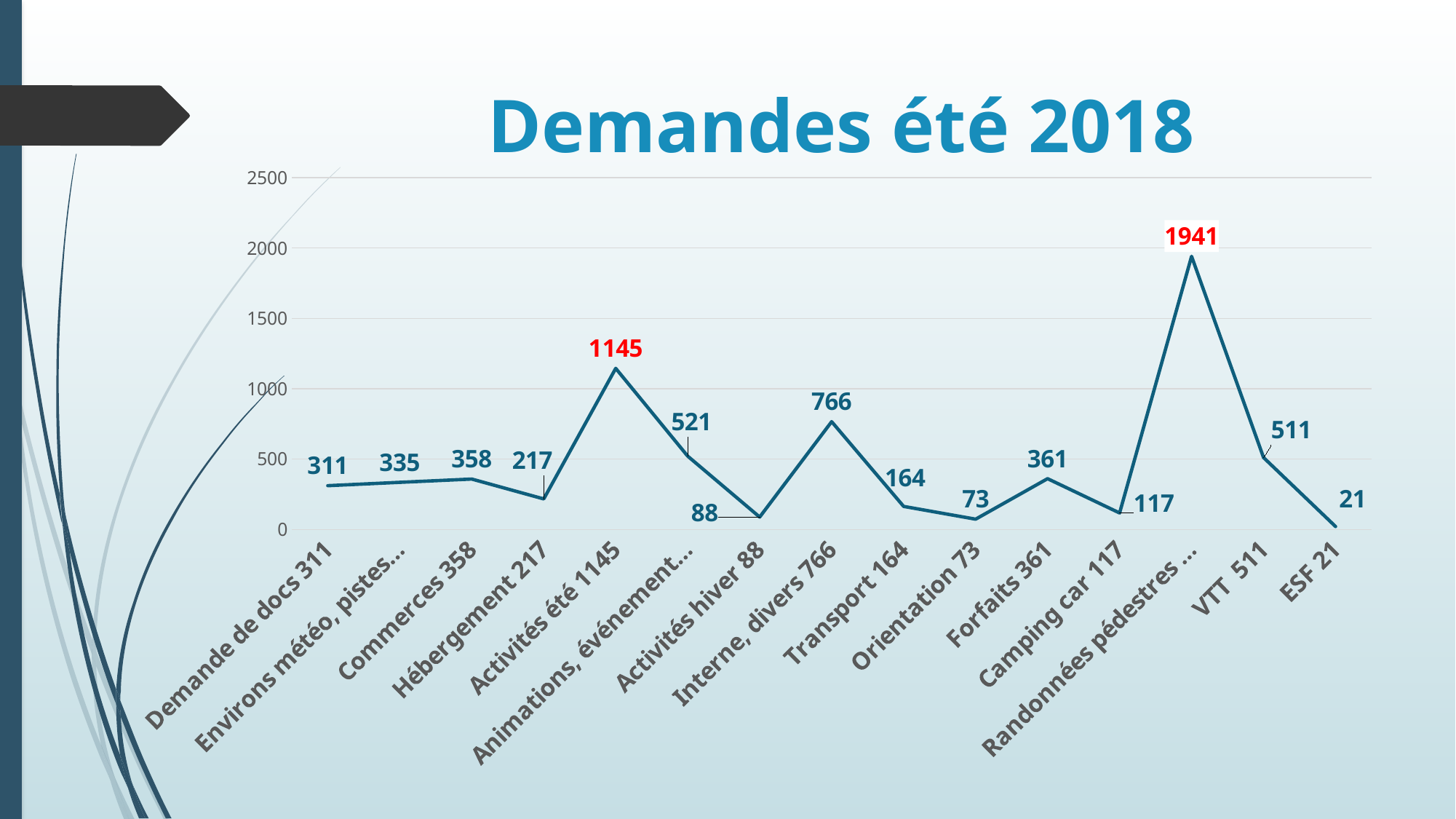
How many data points are plotted on the line? 15 Which category has the highest value? Randonnées pédestres What is the value for VTT? 511 What is the difference between the values for Randonnées pédestres and Activités été? 796 What is the title of the chart? Demandes été 2018 What is the value for Commerces? 358 What is the difference between the values for Transport and Orientation? 91 Which category has the lowest value? ESF What is the value for Activités été? 1145 What is the value for Interne, divers? 766 Which is larger, the value for Forfaits or the value for Hébergement? Forfaits What kind of chart is shown on the slide? line chart